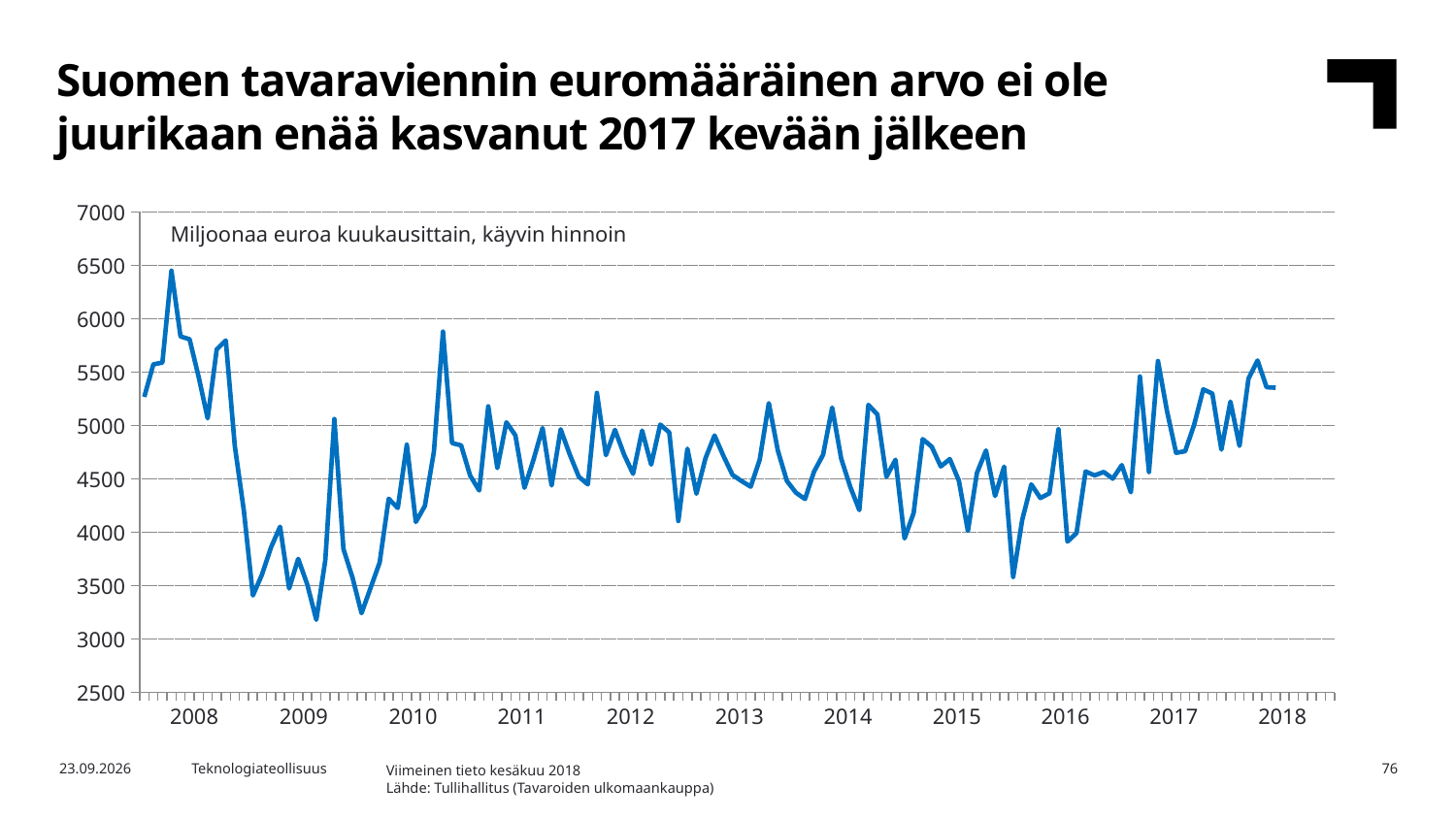
Do the values rise or fall from early 2008 to mid 2009? fall Is the lowest value reached in 2009 greater or less than 3500? less What unit description is printed inside the chart area? Miljoonaa euroa kuukausittain, käyvin hinnoin How many years are labelled on the x axis? 11 In which year does the line reach its highest peak? 2008 Which is higher, the peak in 2008 or the peak in 2017? the peak in 2008 What is the highest value shown on the y axis? 7000 Is the highest value reached in 2008 greater or less than 6000? greater Is the lowest value in 2015 greater or less than 4000? less In which year does the line reach its lowest point? 2009 What kind of chart is shown on the slide? line chart